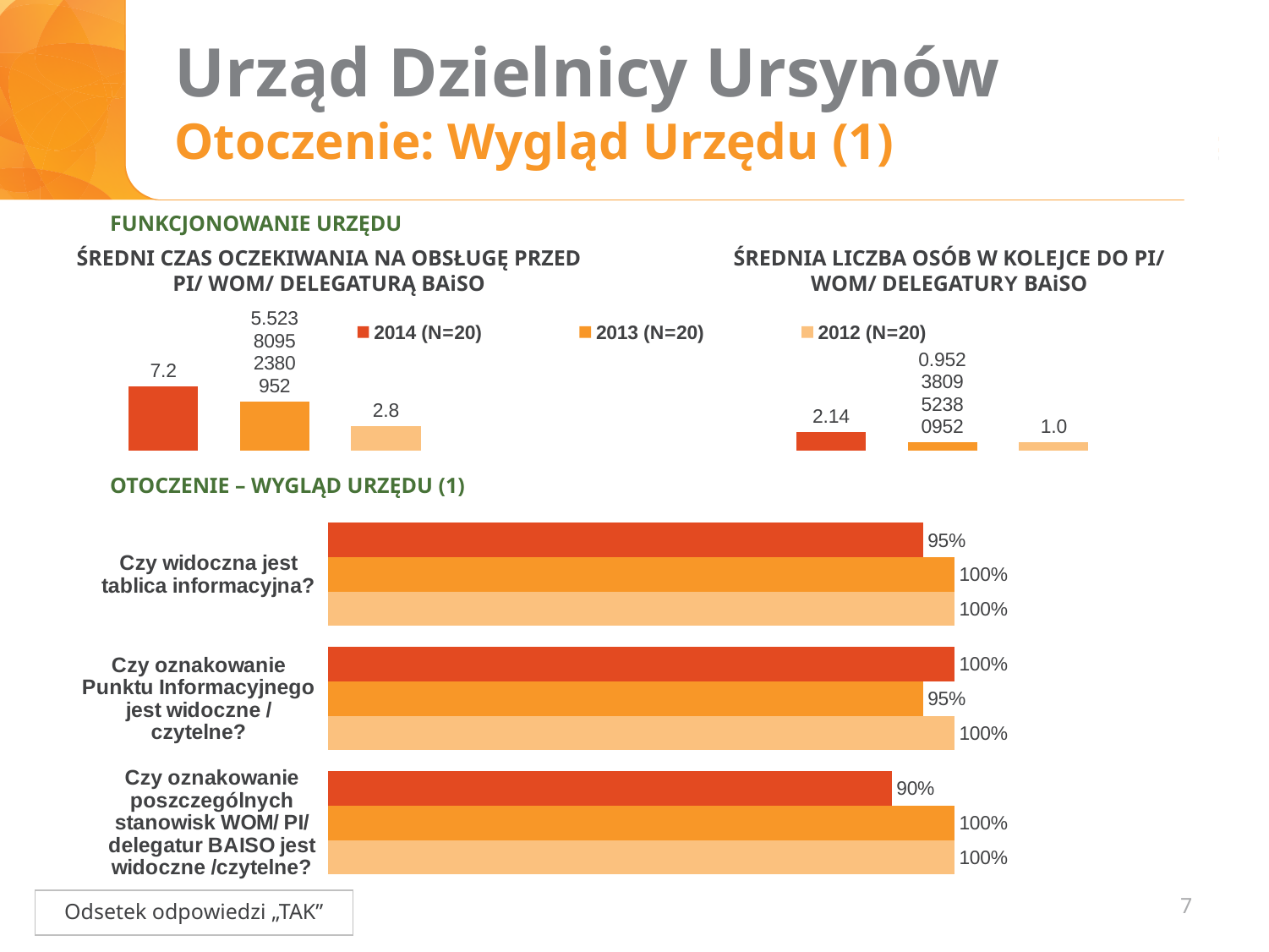
In the bottom chart 'OTOCZENIE – WYGLĄD URZĘDU (1)', what is the 2014 value for 'Czy widoczna jest tablica informacyjna?'? 95% In the chart 'ŚREDNI CZAS OCZEKIWANIA NA OBSŁUGĘ PRZED PI/ WOM/ DELEGATURĄ BAiSO', which year has the highest value? 2014 How many series does the legend above the top charts list? 3 In the chart 'ŚREDNIA LICZBA OSÓB W KOLEJCE DO PI/ WOM/ DELEGATURY BAiSO', what is the value for 2012? 1.0 In the bottom chart 'OTOCZENIE – WYGLĄD URZĘDU (1)', what is the 2014 value for 'Czy oznakowanie poszczególnych stanowisk WOM/ PI/ delegatur BAISO jest widoczne /czytelne?'? 90% What type of chart is the bottom chart 'OTOCZENIE – WYGLĄD URZĘDU (1)'? bar chart In the chart 'ŚREDNI CZAS OCZEKIWANIA NA OBSŁUGĘ PRZED PI/ WOM/ DELEGATURĄ BAiSO', what is the value for 2012? 2.8 In the chart 'ŚREDNI CZAS OCZEKIWANIA NA OBSŁUGĘ PRZED PI/ WOM/ DELEGATURĄ BAiSO', what is the value for 2014? 7.2 In the bottom chart 'OTOCZENIE – WYGLĄD URZĘDU (1)', what is the 2013 value for 'Czy oznakowanie Punktu Informacyjnego jest widoczne / czytelne?'? 95% In the chart 'ŚREDNIA LICZBA OSÓB W KOLEJCE DO PI/ WOM/ DELEGATURY BAiSO', what is the value for 2014? 2.14 In the chart 'ŚREDNI CZAS OCZEKIWANIA NA OBSŁUGĘ PRZED PI/ WOM/ DELEGATURĄ BAiSO', what is the difference between the 2014 and 2012 values? 4.4 In the chart 'ŚREDNIA LICZBA OSÓB W KOLEJCE DO PI/ WOM/ DELEGATURY BAiSO', which year has the lowest value? 2013